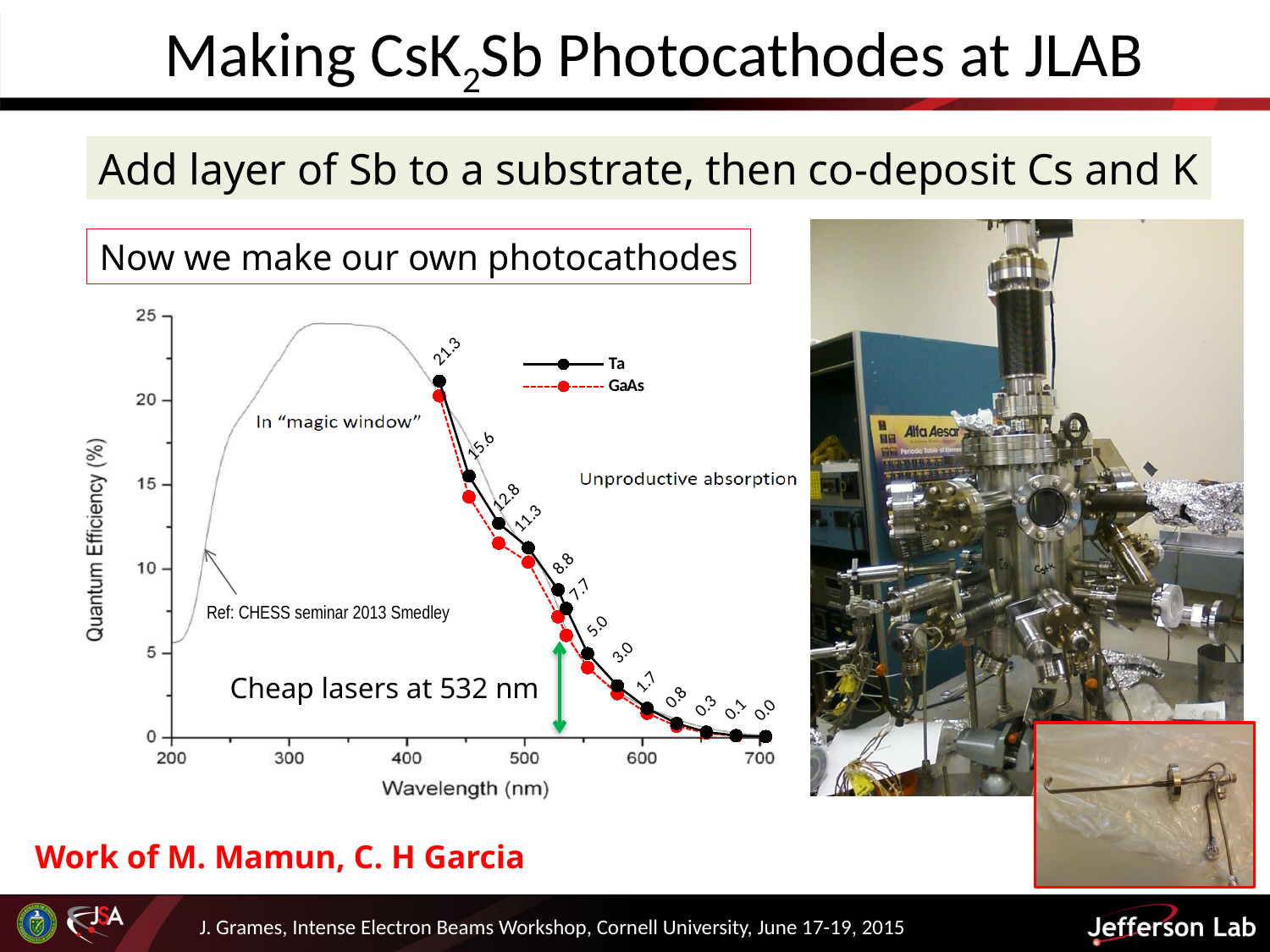
Near 450 nm, which series has the higher quantum efficiency, Ta or GaAs? Ta What is the label of the chart's y axis? Quantum Efficiency (%) What are the two series named in the chart legend? Ta and GaAs How many data labels are printed along the Ta curve? 13 What is the difference between the first two data labels on the Ta curve, 21.3 and 15.6? 5.7 How many series does the chart legend list? 2 What is the difference between the data labels 12.8 and 11.3 on the Ta curve? 1.5 At the 532 nm wavelength marked by the green arrow, is the Ta quantum efficiency greater or less than 10? less Does the quantum efficiency of the Ta and GaAs curves rise or fall as wavelength increases from 425 nm to 700 nm? fall What type of chart is shown on the slide? line chart What is the highest data label printed on the chart? 21.3 What is the lowest data label printed on the chart? 0.0